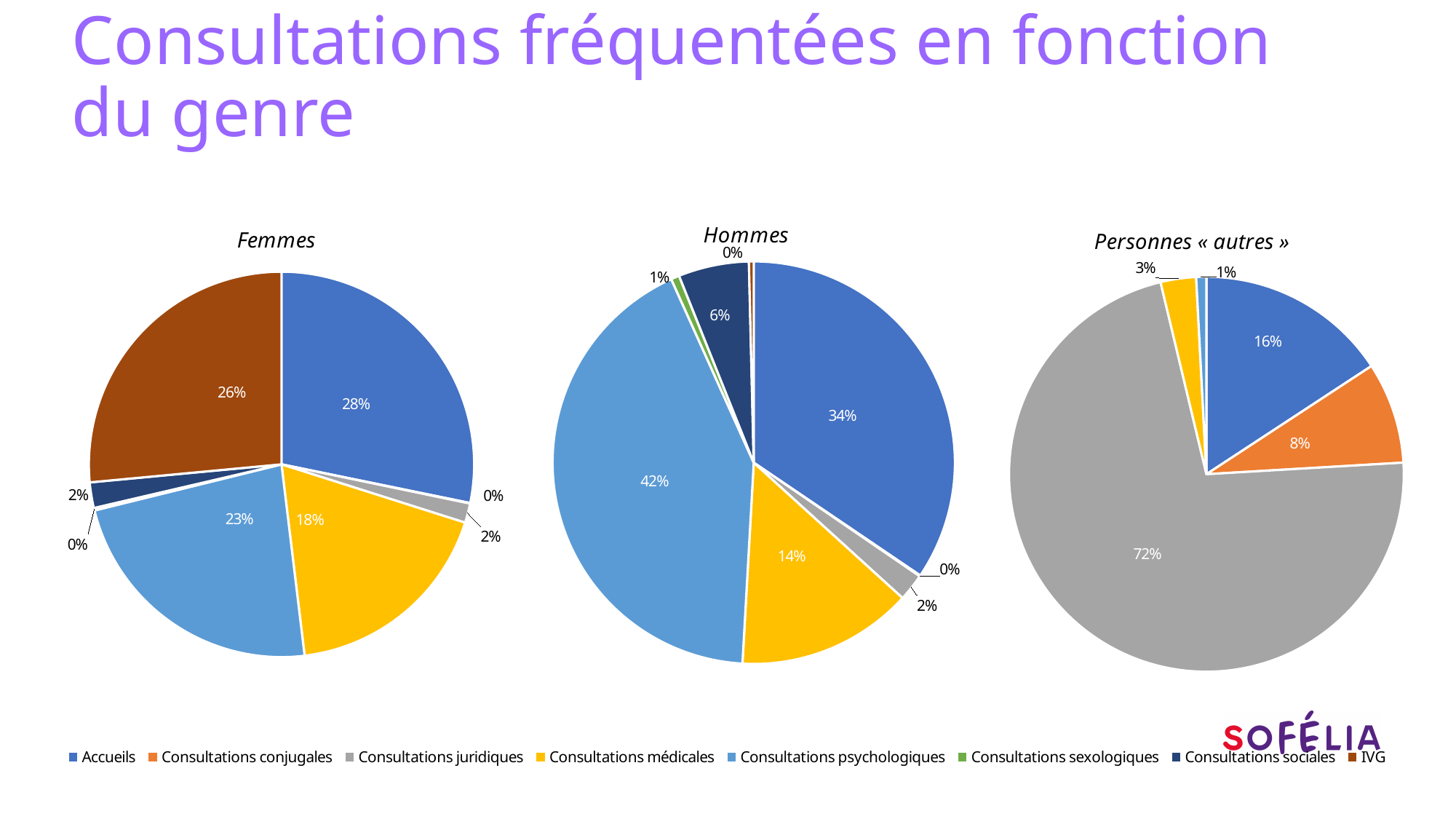
In the Hommes pie chart, what share is Consultations sociales? 6% In the Femmes pie chart, what share is IVG? 26% In the Femmes pie chart, which category has the largest share? Accueils What type of chart is used on this slide? Pie chart How many categories does the legend list? 8 In the Femmes pie chart, which is larger: Consultations psychologiques or Consultations médicales? Consultations psychologiques In the Hommes pie chart, which category has the largest share? Consultations psychologiques What is the difference between the Accueils share in the Hommes chart and the Accueils share in the Femmes chart? 6% In the Hommes pie chart, what share is Consultations psychologiques? 42%